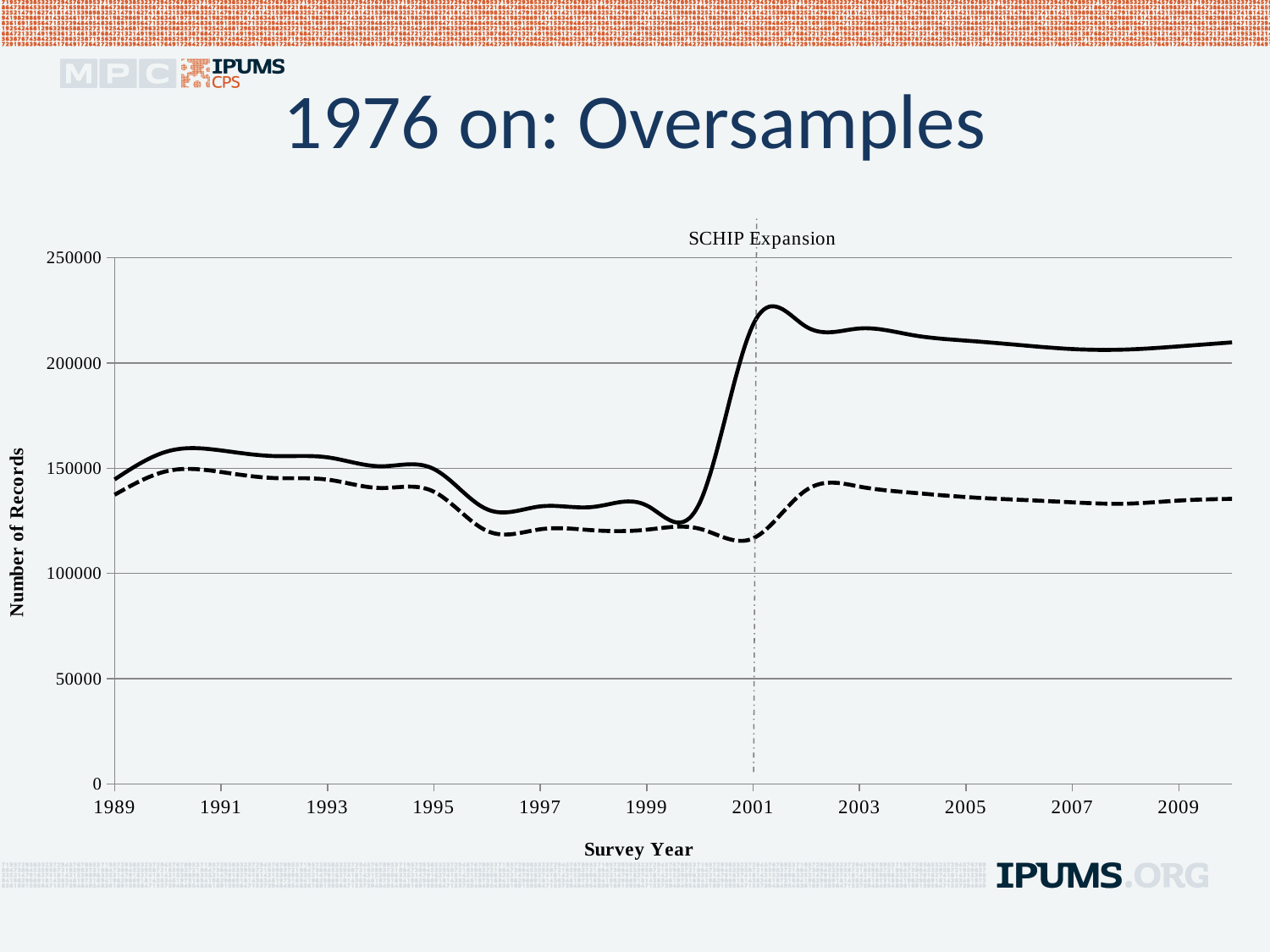
Is the value of the solid line in 2003 greater or less than 200000? greater In 2005, which line has the higher value, the solid line or the dashed line? the solid line Does the dashed line rise or fall between 1989 and 2001 overall? fall Is the value of the dashed line in 2001 greater or less than 150000? less What is the title of the slide containing the chart? 1976 on: Oversamples How many lines are plotted on the chart? 2 Does the solid line rise or fall between 1999 and 2001? rise What kind of chart is shown on the slide? line chart At which survey year is the vertical dash-dot line labelled 'SCHIP Expansion' placed? 2001 Is the value of the solid line in 1997 greater or less than 150000? less What is the label on the y-axis of the chart? Number of Records